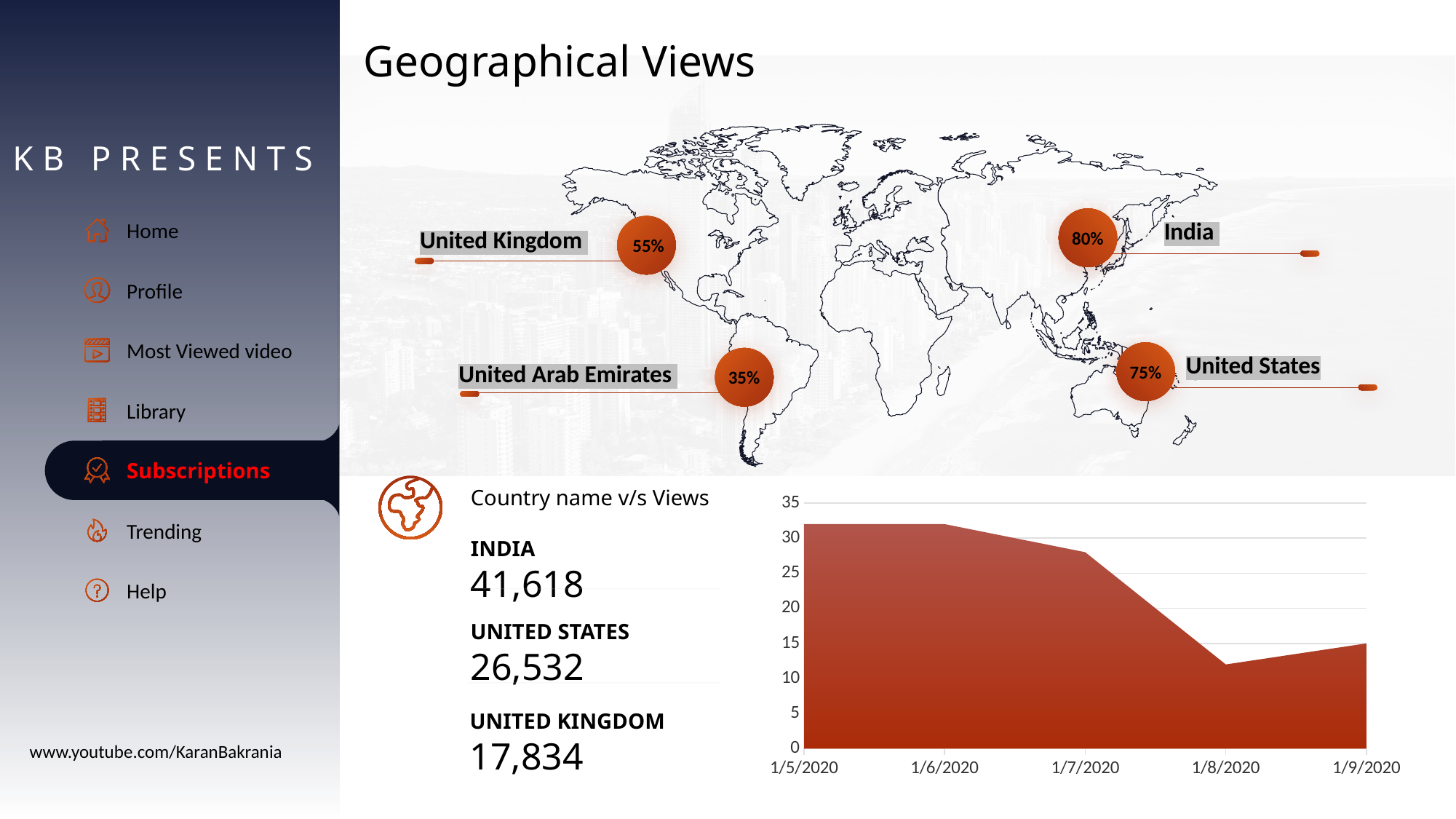
In the area chart, is the value for 1/9/2020 greater or less than 20? less In the area chart, is the value for 1/7/2020 greater or less than 25? greater What is the highest tick value shown on the y axis of the area chart? 35 Which date has the lowest value in the area chart? 1/8/2020 Do the values in the area chart generally rise or fall from 1/5/2020 to 1/9/2020? fall In the area chart, is the value for 1/6/2020 greater or less than 30? greater In the area chart, which has the larger value, 1/7/2020 or 1/8/2020? 1/7/2020 How many dates are plotted along the x axis of the area chart? 5 In the area chart, which has the larger value, 1/8/2020 or 1/9/2020? 1/9/2020 What kind of chart is shown at the bottom right of the slide? area chart